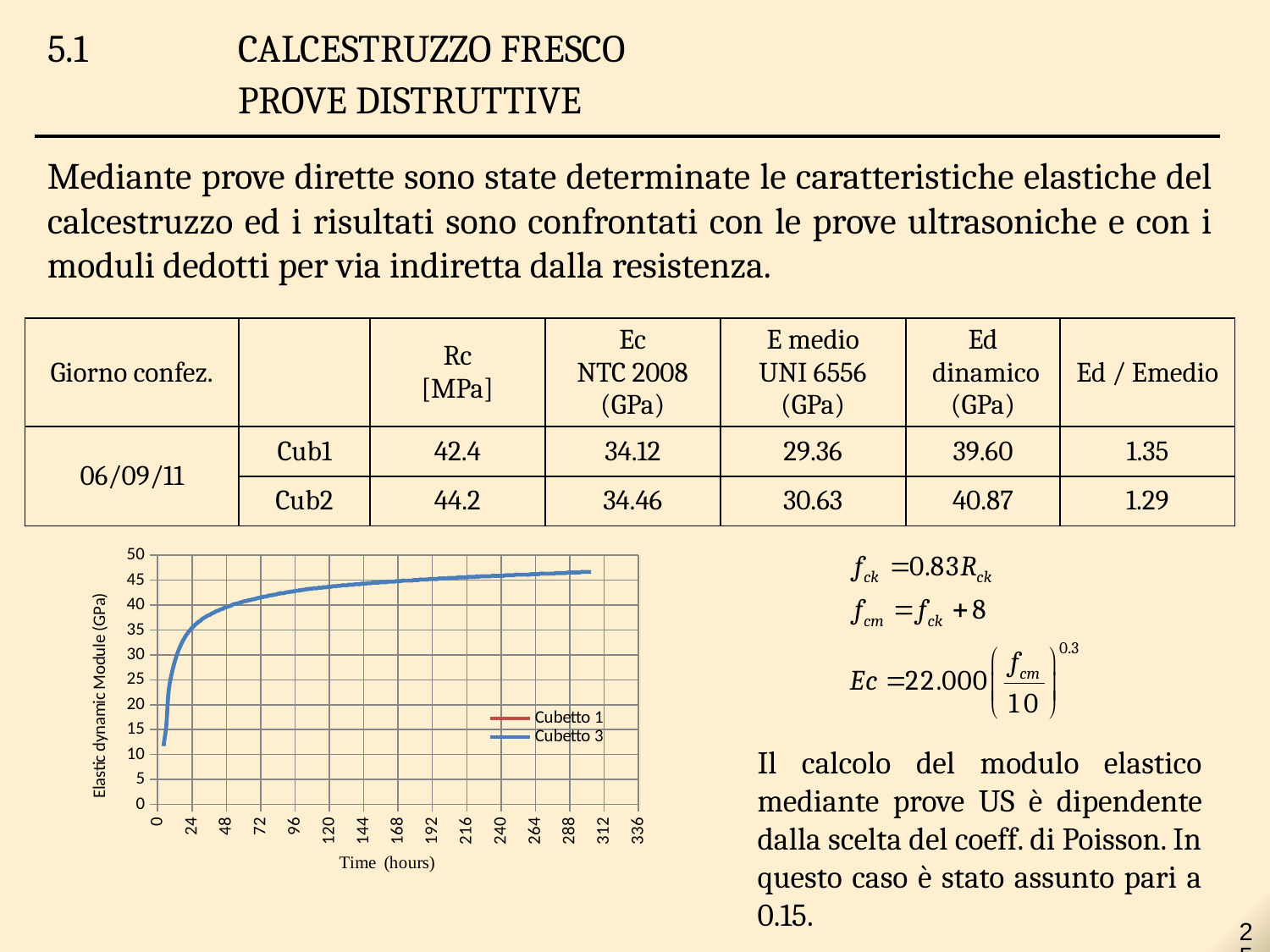
Is the value of the curve at 288 hours greater or less than 40? greater Is the value of the curve at 24 hours greater or less than 30? greater Is the starting value of the curve near 0 hours greater or less than 20? less How many series does the chart legend list? 2 Does the elastic dynamic module rise or fall as time increases along the x axis? rise What kind of chart is shown on the slide? line chart What are the two series named in the chart legend? Cubetto 1 and Cubetto 3 What is the label of the chart's y axis? Elastic dynamic Module (GPa) What is the highest value shown on the chart's y axis? 50